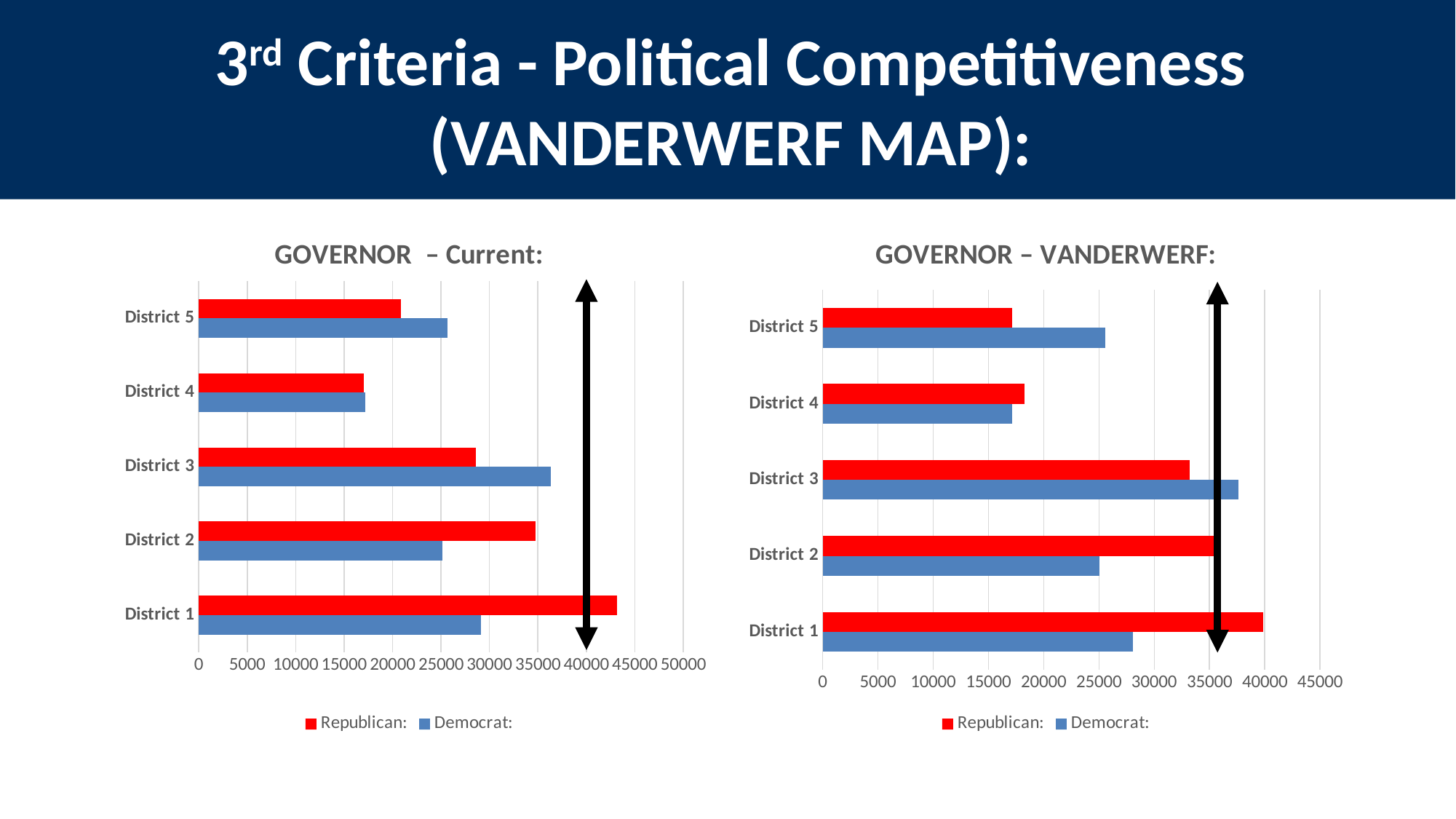
In the GOVERNOR – Current chart, which district has the highest Republican value? District 1 What colour represents the Democrat series in the GOVERNOR – Current chart? blue In the GOVERNOR – Current chart, which district has the highest Democrat value? District 3 In the GOVERNOR – VANDERWERF chart, which district has the lowest Democrat value? District 4 How many series does the legend of the GOVERNOR – VANDERWERF chart list? 2 In the GOVERNOR – VANDERWERF chart, is the Democrat value for District 5 greater or less than 20000? greater In the GOVERNOR – Current chart, which is larger for District 2, the Republican value or the Democrat value? Republican In the GOVERNOR – Current chart, is the Republican value for District 1 greater or less than 40000? greater How many districts are shown on the GOVERNOR – Current chart? 5 In the GOVERNOR – VANDERWERF chart, which is larger for District 3, the Republican value or the Democrat value? Democrat In the GOVERNOR – VANDERWERF chart, is the Republican value for District 4 greater or less than 20000? less What type of chart is the GOVERNOR – Current chart? bar chart